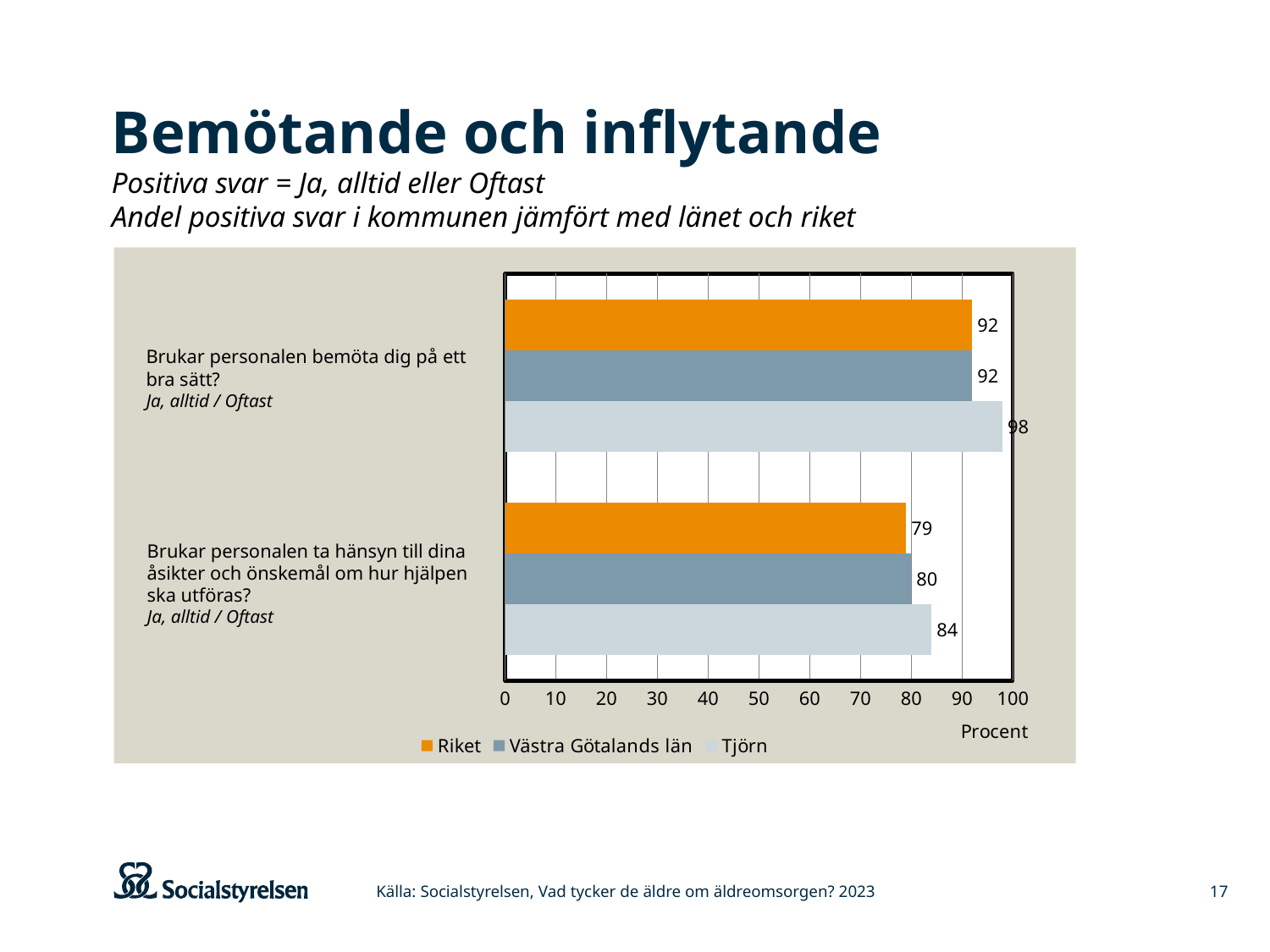
What is the value for Tjörn on the question "Brukar personalen bemöta dig på ett bra sätt?"? 98 What is the value for Tjörn on the question "Brukar personalen ta hänsyn till dina åsikter och önskemål om hur hjälpen ska utföras?"? 84 What kind of chart is shown on the slide? Bar chart What is the label on the horizontal axis of the chart? Procent What is the difference between Tjörn and Riket on the question "Brukar personalen bemöta dig på ett bra sätt?"? 6 What is the value for Riket on the question "Brukar personalen ta hänsyn till dina åsikter och önskemål om hur hjälpen ska utföras?"? 79 Which is larger: Tjörn's value for "Brukar personalen bemöta dig på ett bra sätt?" or Tjörn's value for "Brukar personalen ta hänsyn till dina åsikter och önskemål om hur hjälpen ska utföras?"? Brukar personalen bemöta dig på ett bra sätt? What is the difference between Tjörn and Västra Götalands län on the question "Brukar personalen ta hänsyn till dina åsikter och önskemål om hur hjälpen ska utföras?"? 4 Which series has the highest value on the question "Brukar personalen bemöta dig på ett bra sätt?"? Tjörn How many series does the legend list? 3 Which series has the lowest value on the question "Brukar personalen ta hänsyn till dina åsikter och önskemål om hur hjälpen ska utföras?"? Riket What is the value for Västra Götalands län on the question "Brukar personalen ta hänsyn till dina åsikter och önskemål om hur hjälpen ska utföras?"? 80